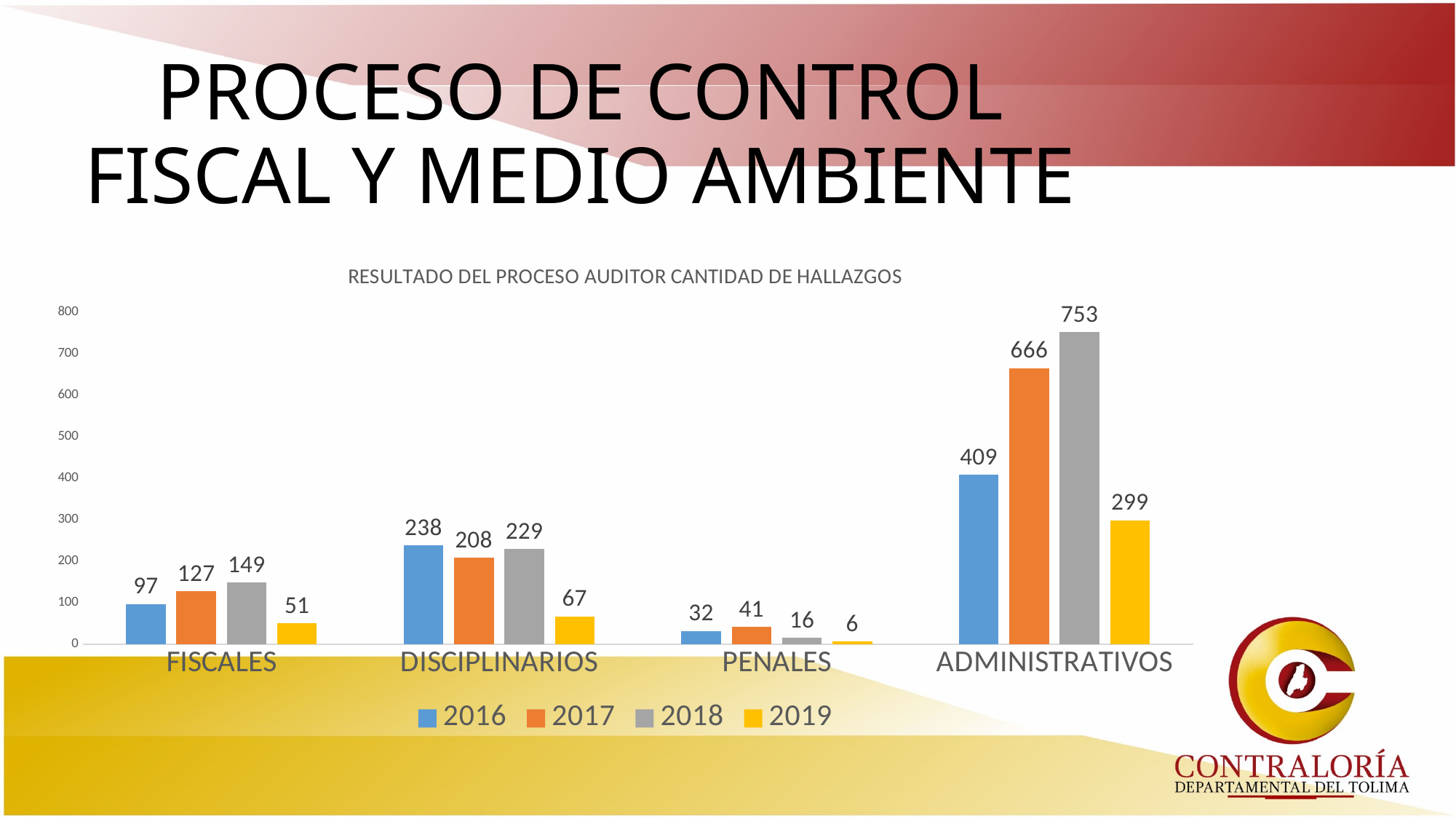
How many categories are shown on the x axis? 4 Which category has the highest value in 2017? ADMINISTRATIVOS Is the value for ADMINISTRATIVOS in 2017 greater or less than 600? greater What is the difference between the 2018 and 2019 values for ADMINISTRATIVOS? 454 What is the value for ADMINISTRATIVOS in 2018? 753 How many series does the legend list? 4 What is the value for PENALES in 2019? 6 Which category has the lowest value in 2018? PENALES What is the value for FISCALES in 2016? 97 What kind of chart is shown? bar chart What is the title of the chart? RESULTADO DEL PROCESO AUDITOR CANTIDAD DE HALLAZGOS Which is larger for DISCIPLINARIOS: the 2016 value or the 2018 value? 2016